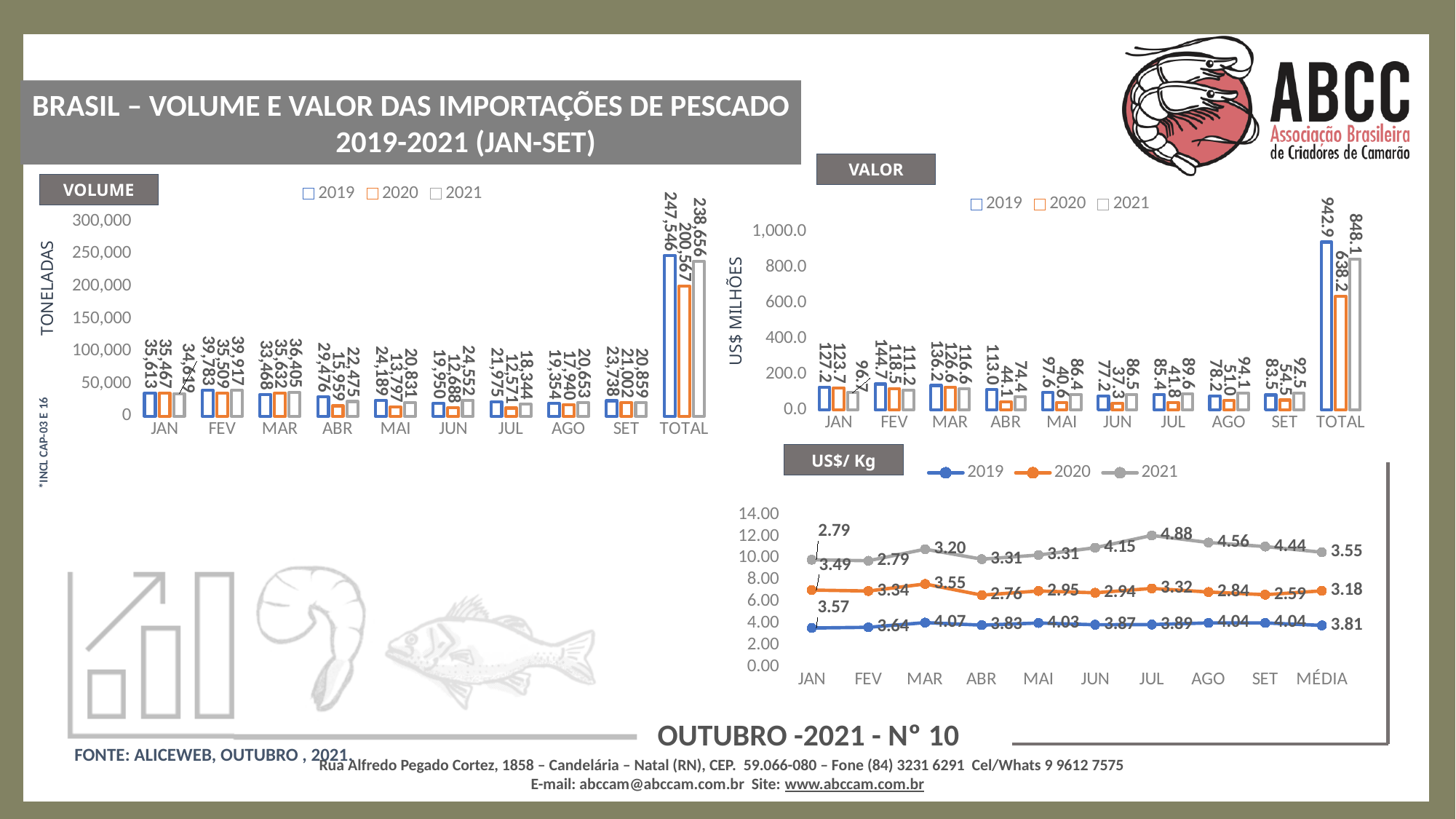
What kind of chart is the US$/Kg chart? line chart In the US$/Kg chart, what is the MÉDIA value for 2020? 3.18 In the VALOR chart, what is the 2021 value for JAN? 96.7 In the VALOR chart, which month has the highest 2019 value (excluding TOTAL)? FEV In the VALOR chart, is the 2020 value for ABR larger or smaller than the 2021 value for ABR? smaller In the VALOR chart, what is the 2020 value for TOTAL? 638.2 In the VOLUME chart, what is the difference between the 2019 and 2020 TOTAL values? 46,979 In the US$/Kg chart, what is the 2021 value for JUL? 4.88 In the VOLUME chart, which year has the lowest TOTAL? 2020 In the VOLUME chart, what is the 2019 value for TOTAL? 247,546 In the US$/Kg chart, how many series does the legend list? 3 In the VOLUME chart, what is the 2020 value for ABR? 15,959